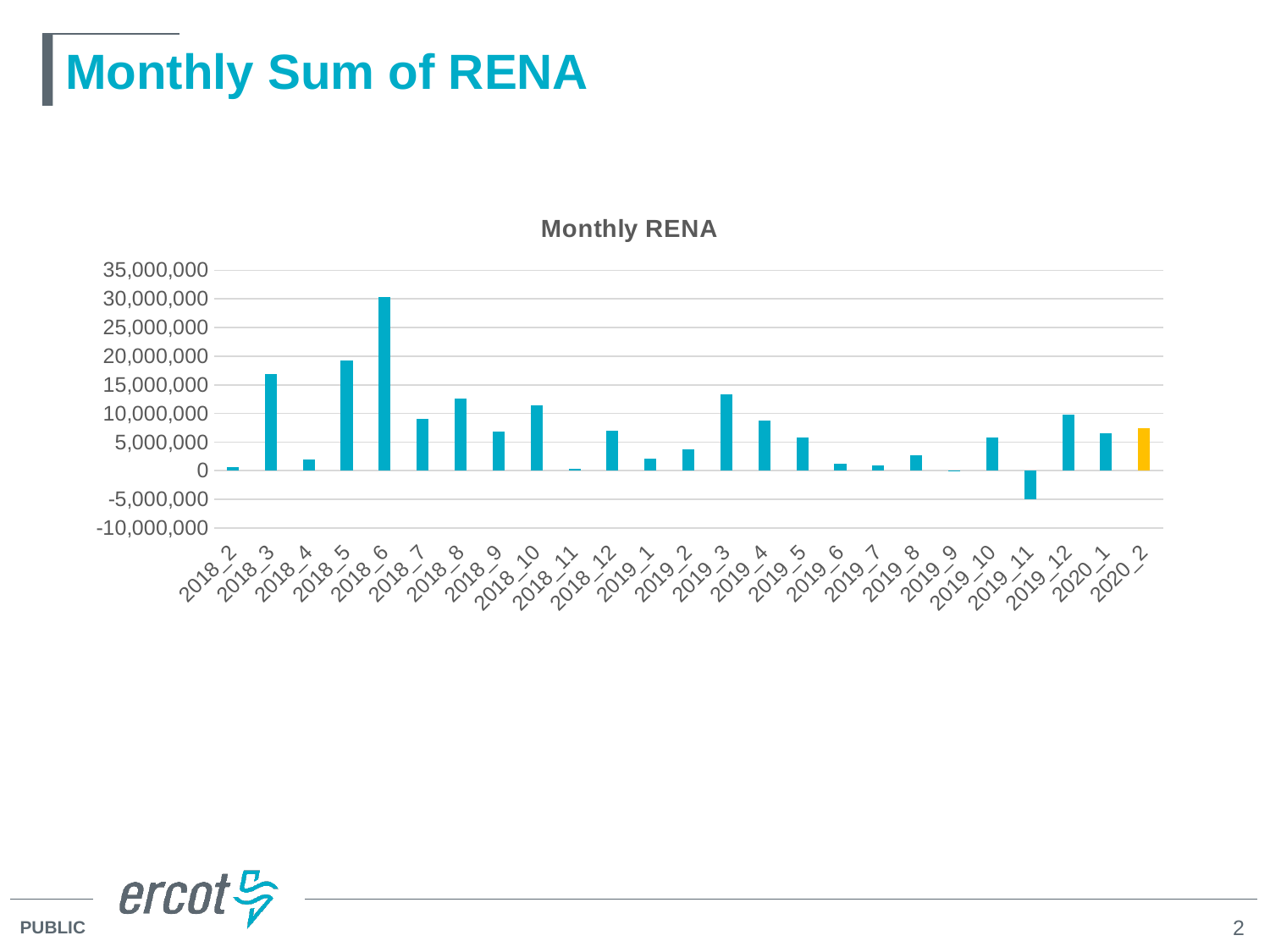
Is the value for 2019_3 greater or less than 10,000,000? greater Which month has the lowest Monthly RENA value? 2019_11 What is the title of the chart? Monthly RENA Is the value for 2020_2 greater or less than 5,000,000? greater Is the value for 2018_5 greater or less than 20,000,000? less How many months (categories) are plotted on the x axis? 25 What kind of chart is shown on the slide? bar chart Which month's bar is shown in a different colour (yellow) from the rest? 2020_2 Which is larger, the value for 2019_3 or the value for 2019_4? 2019_3 Which month has the highest Monthly RENA value? 2018_6